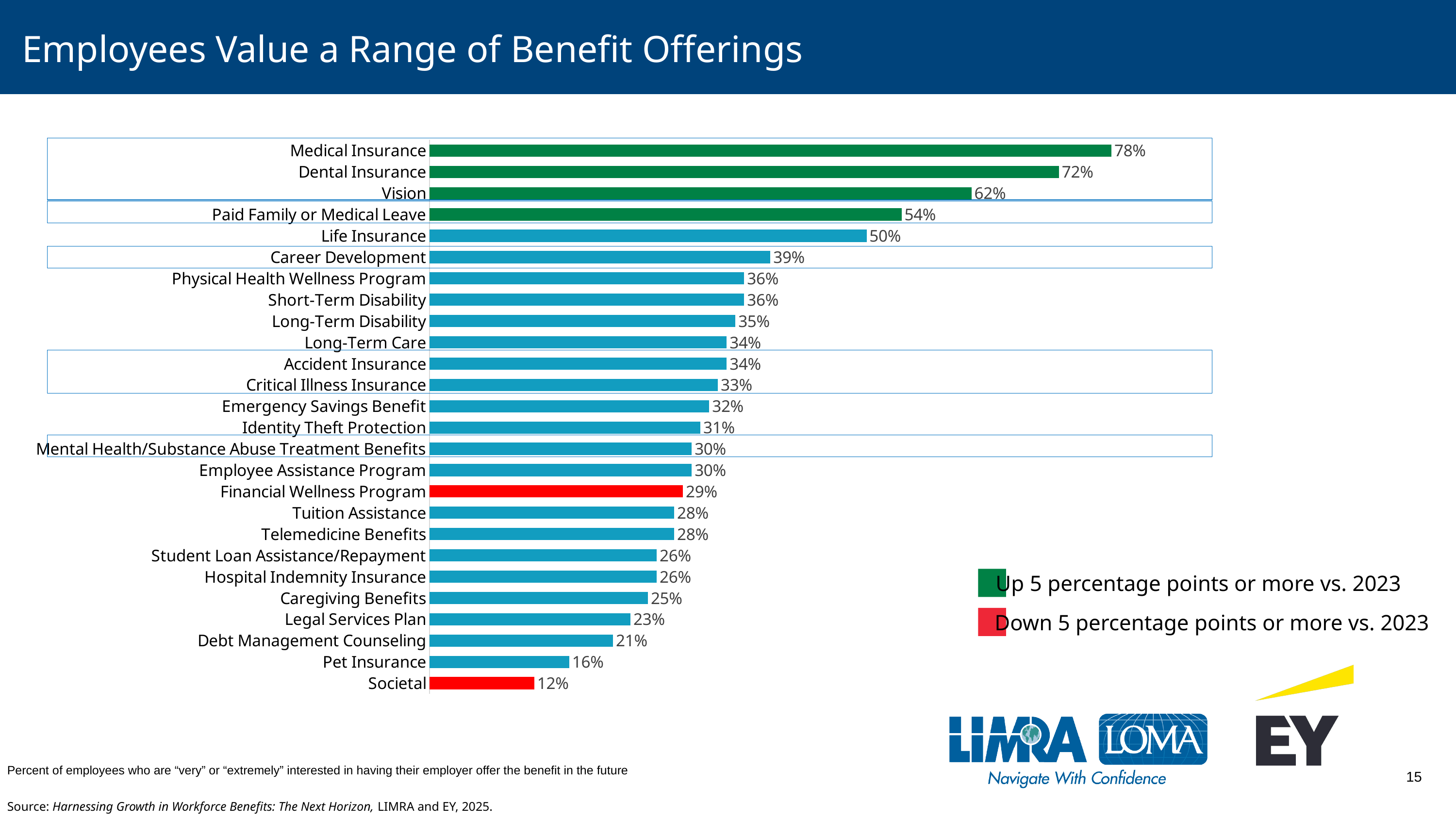
Which has a higher value, Vision or Life Insurance? Vision According to the legend, what does a red bar indicate? Down 5 percentage points or more vs. 2023 How many benefit categories are shown in the chart? 26 What type of chart is shown on the slide? Bar chart Which benefit has the highest percentage of interested employees? Medical Insurance What percentage of employees are very or extremely interested in Medical Insurance? 78% Which has a higher value, Legal Services Plan or Debt Management Counseling? Legal Services Plan Which benefit has the lowest percentage of interested employees? Societal What is the value shown for Career Development? 39% What is the difference in percentage points between Paid Family or Medical Leave and Life Insurance? 4 What is the value shown for Pet Insurance? 16% What is the difference in percentage points between Medical Insurance and Dental Insurance? 6